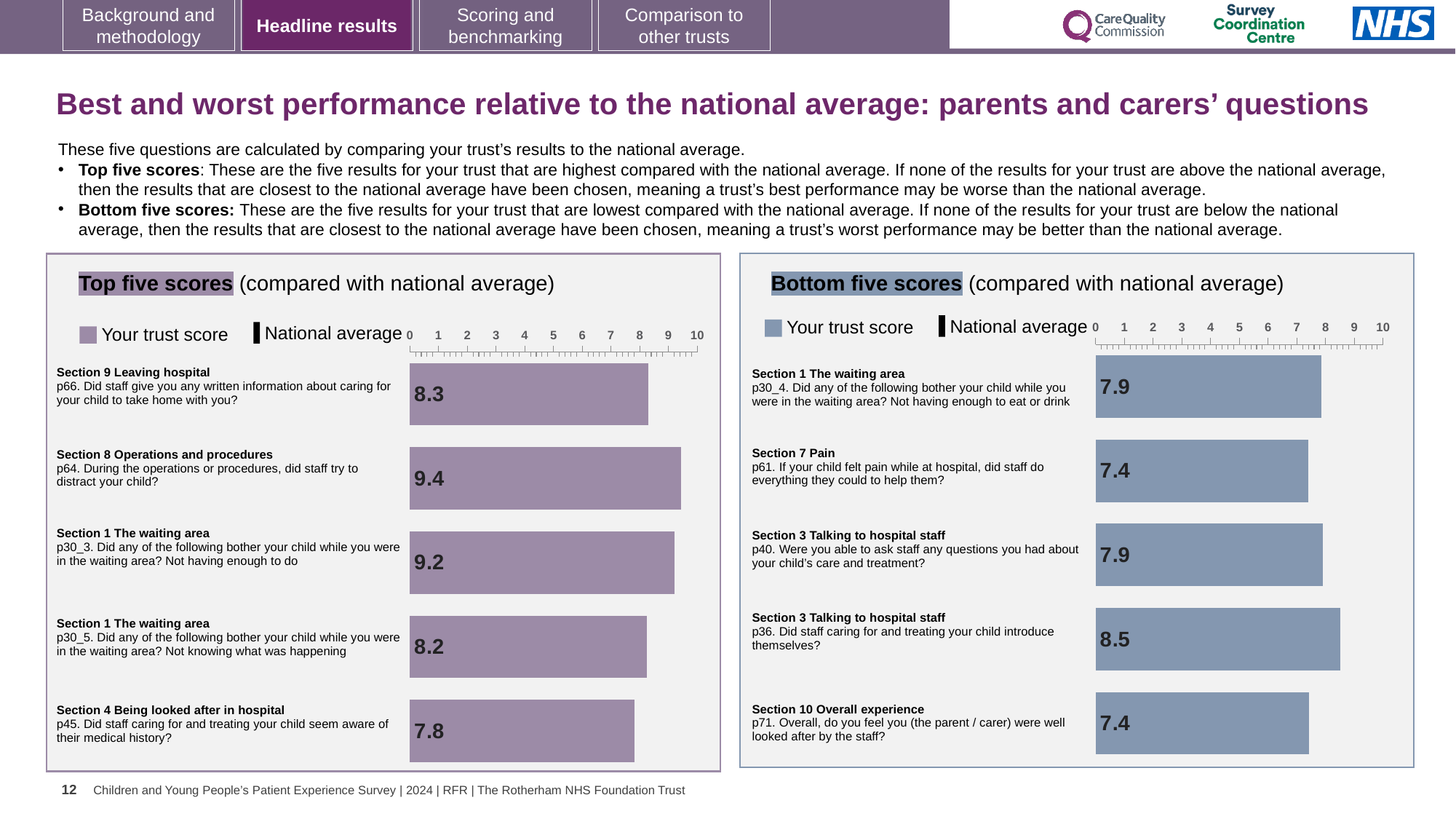
In the Top five scores chart, what is the trust score for p64 (During the operations or procedures, did staff try to distract your child?)? 9.4 In the Top five scores chart, which question has the highest trust score? p64 (9.4) How many bars are shown in the Bottom five scores chart? 5 In the Bottom five scores chart, what is the trust score for p61 (If your child felt pain while at hospital, did staff do everything they could to help them?)? 7.4 In the Bottom five scores chart, which question has the highest trust score? p36 (8.5) In the Top five scores chart, what is the difference between the trust scores for p64 and p45? 1.6 In the Bottom five scores chart, what is the difference between the trust scores for p36 and p71? 1.1 In the Top five scores chart, which has the larger trust score: p66 or p30_5? p66 What kind of chart is the Top five scores chart? Bar chart In the Top five scores chart, which question has the lowest trust score? p45 (7.8) In the Bottom five scores chart, what is the trust score for p36 (Did staff caring for and treating your child introduce themselves?)? 8.5 How many entries does the legend of the Top five scores chart list? 2